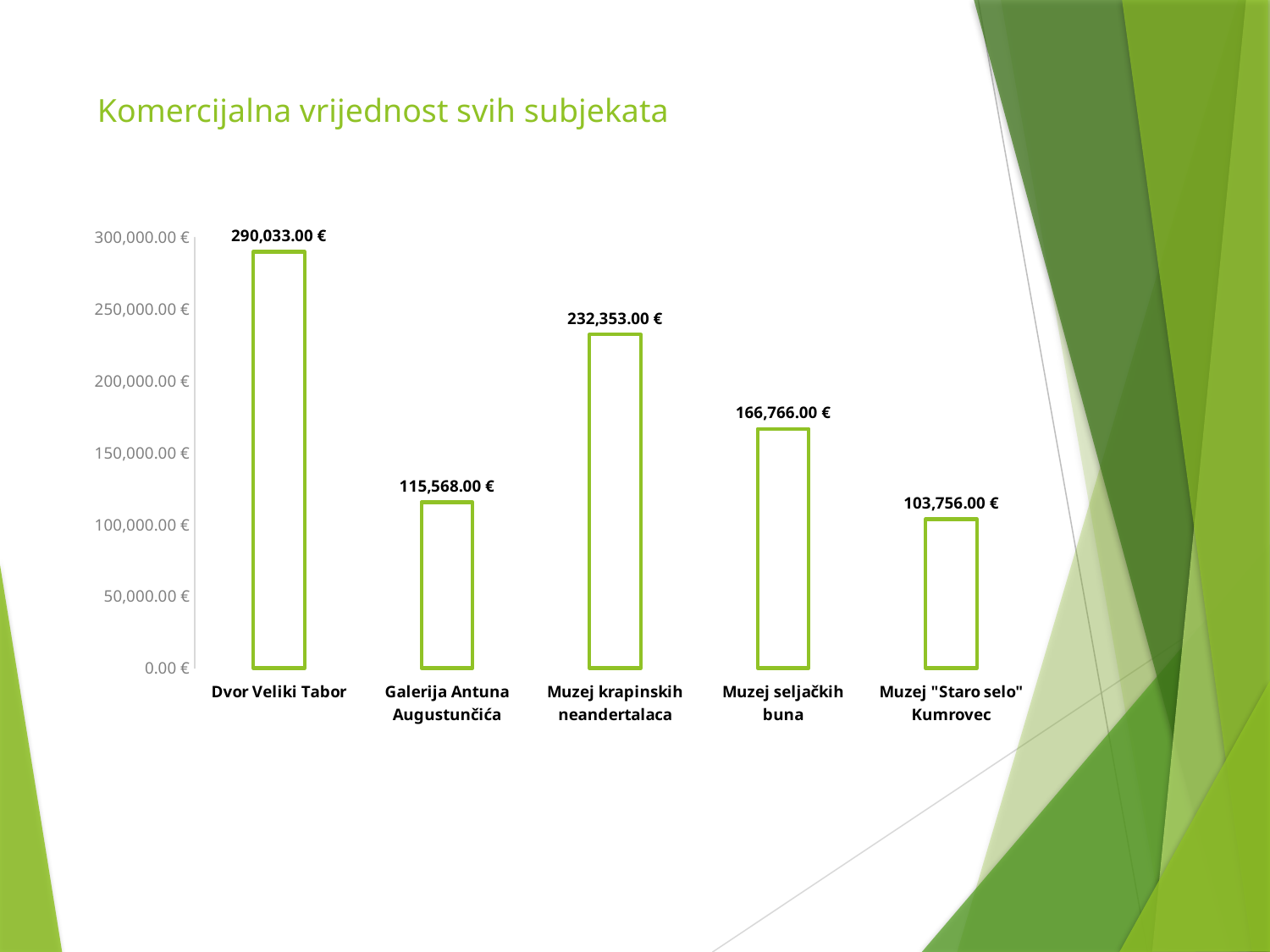
What is the title of the slide? Komercijalna vrijednost svih subjekata What is the value for Muzej krapinskih neandertalaca? 232,353.00 € Which category has the highest value? Dvor Veliki Tabor Which is larger, the value for Galerija Antuna Augustunčića or the value for Muzej seljačkih buna? Muzej seljačkih buna What is the value for Dvor Veliki Tabor? 290,033.00 € What is the difference between the values for Muzej seljačkih buna and Galerija Antuna Augustunčića? 51,198.00 € How many categories are shown in the chart? 5 Is the value for Muzej seljačkih buna greater or less than 150,000.00 €? greater Which category has the lowest value? Muzej "Staro selo" Kumrovec What is the value for Muzej "Staro selo" Kumrovec? 103,756.00 € What kind of chart is shown on the slide? bar chart What is the difference between the values for Dvor Veliki Tabor and Muzej krapinskih neandertalaca? 57,680.00 €